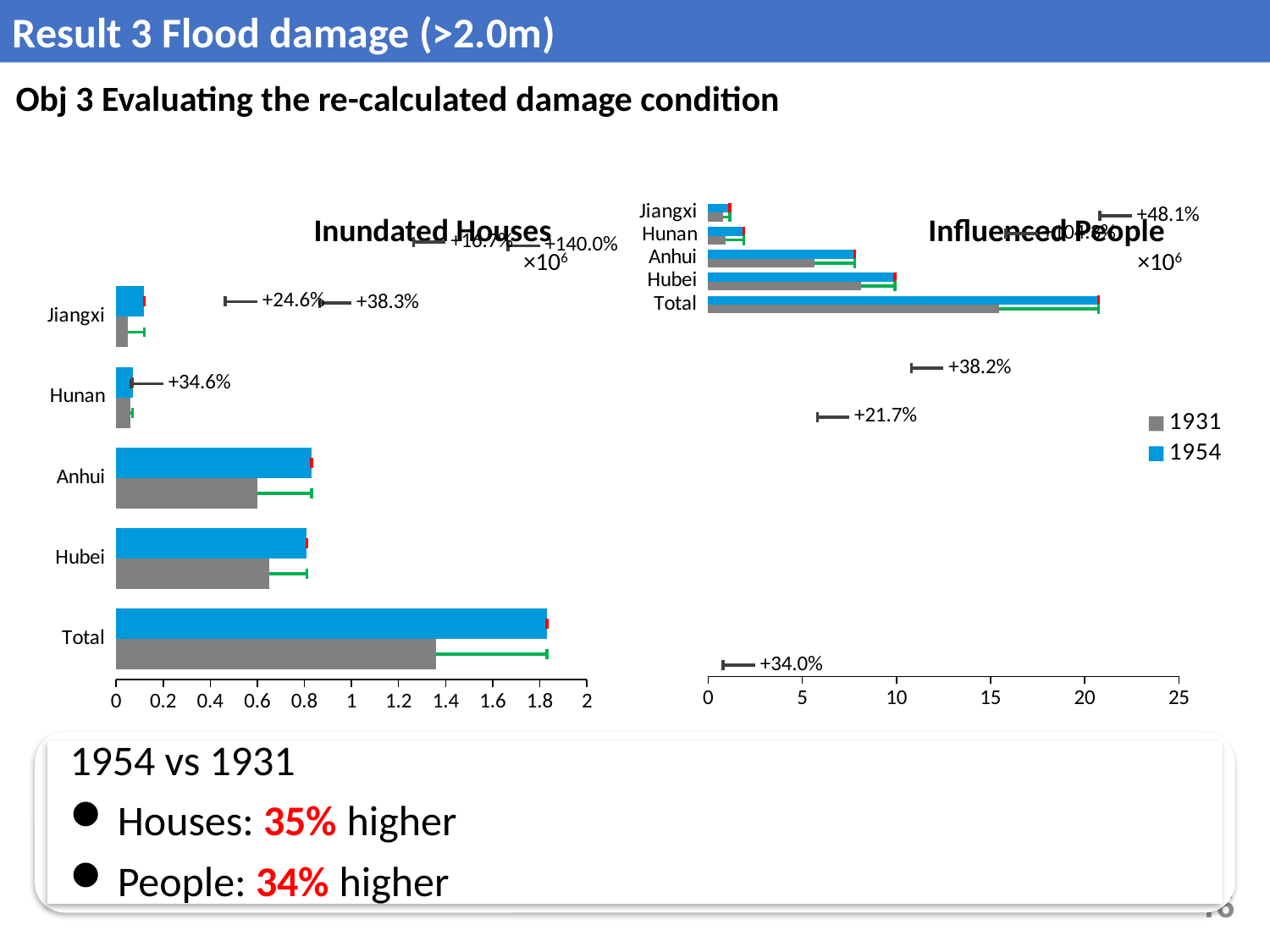
In the Inundated Houses chart, is the 1931 value for Total greater or less than 1.2? greater How many categories are shown on the Influenced People chart? 5 In the Influenced People chart, which category has the lowest 1954 value? Jiangxi In the Inundated Houses chart, is the 1954 value for Anhui greater or less than 0.6? greater What kind of chart is the Inundated Houses chart? bar chart In the Inundated Houses chart, which category has the highest 1954 value? Total Which two years are listed in the legend? 1931 and 1954 In the Influenced People chart, is the 1954 value for Anhui greater or less than 10? less How many series does the legend list for the charts? 2 In the Inundated Houses chart, which category has the lowest 1954 value? Hunan In the Influenced People chart, which is larger for Total: the 1954 value or the 1931 value? 1954